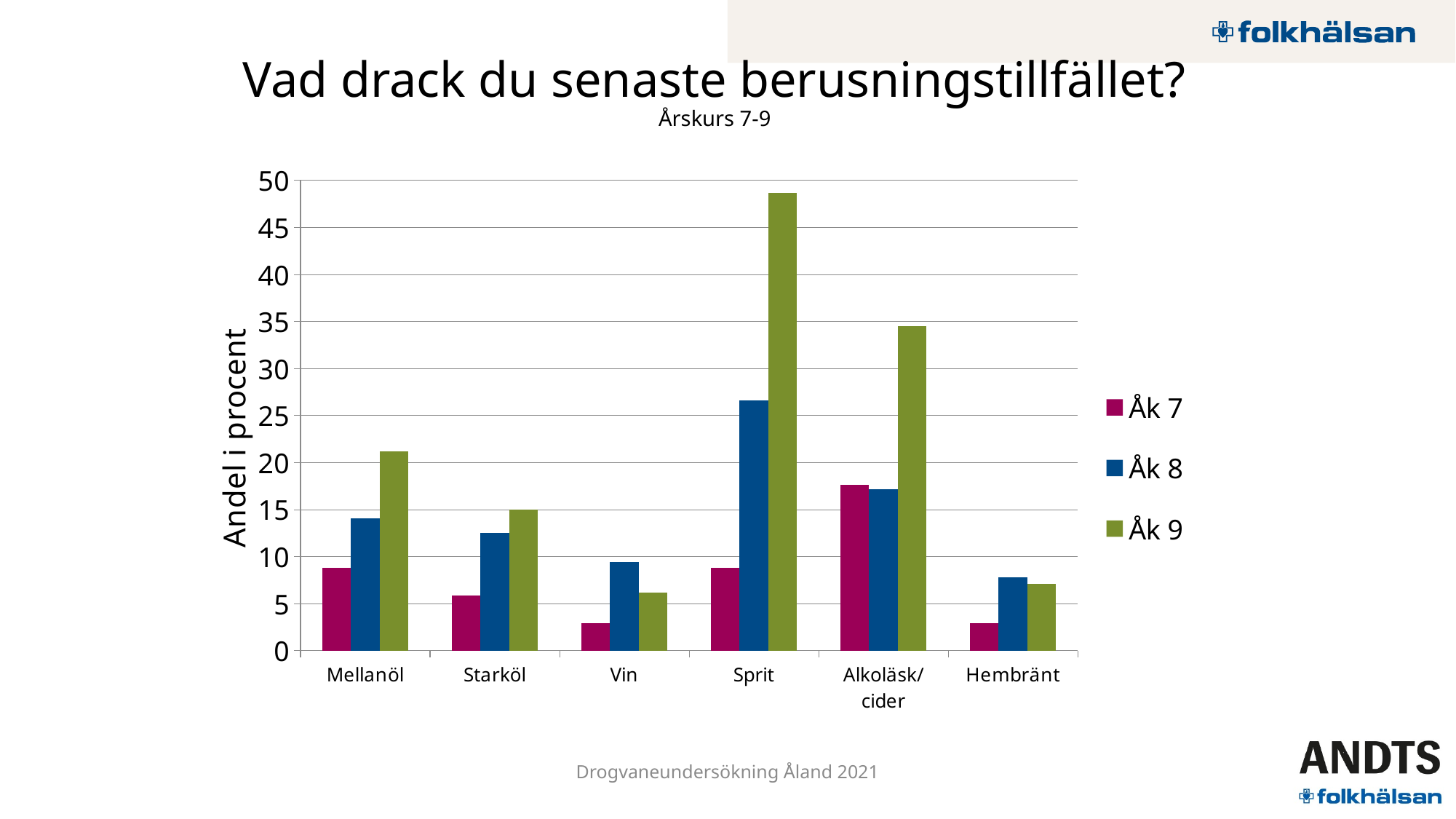
Is the value for Vin in the Åk 7 series greater or less than 5? less Which category has the highest value for Åk 9? Sprit How many series does the legend list? 3 What is the label of the y axis? Andel i procent Is the value for Sprit in the Åk 9 series greater or less than 45? greater For Mellanöl, which series has the larger value, Åk 8 or Åk 9? Åk 9 What kind of chart is shown on the slide? bar chart Which category has the highest value for Åk 8? Sprit Which category has the lowest value for Åk 9? Vin Is the value for Alkoläsk/cider in the Åk 9 series greater or less than 30? greater Which category has the highest value for Åk 7? Alkoläsk/cider How many categories are shown on the x axis? 6